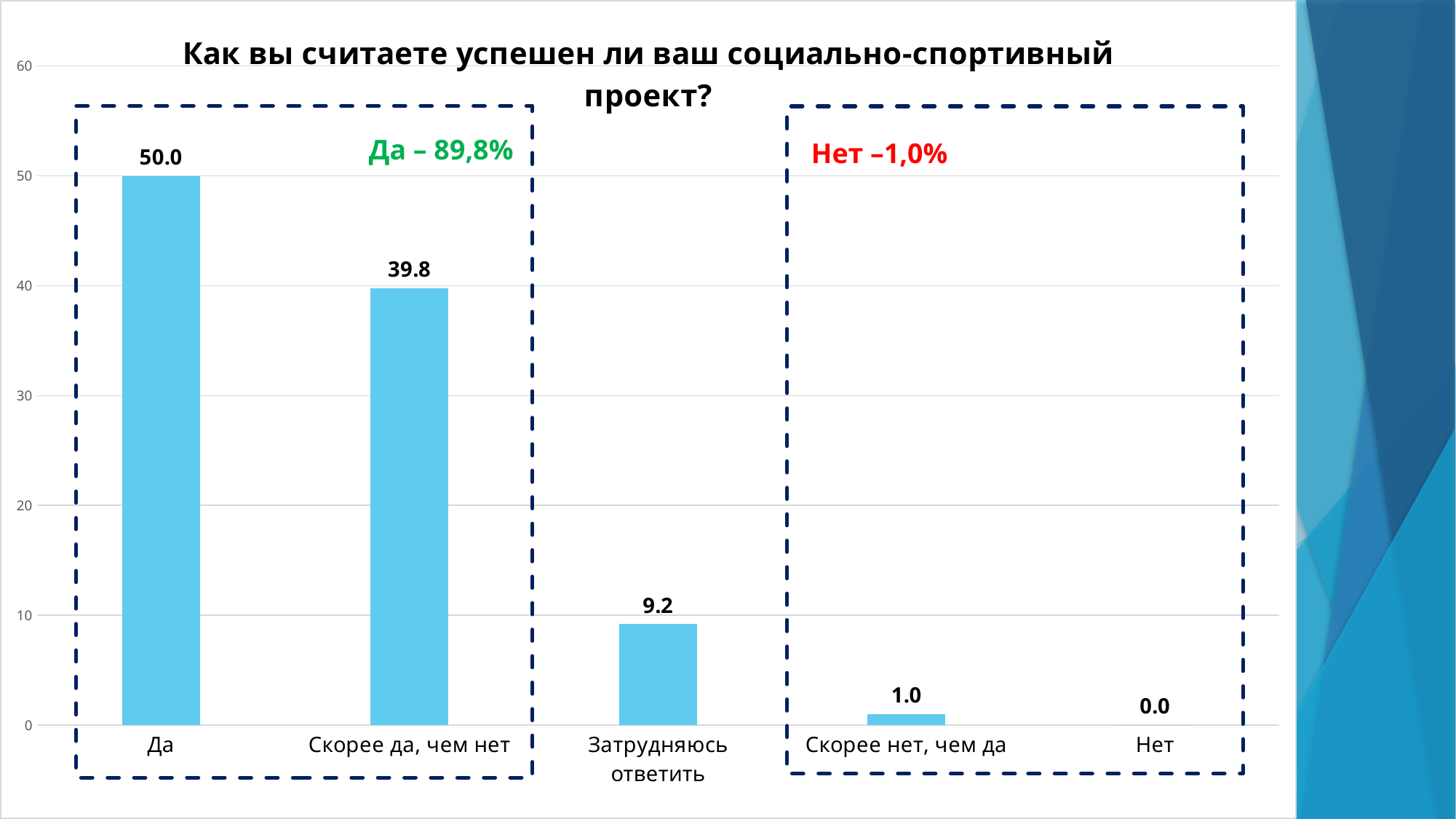
What is the difference between the values for "Да" and "Скорее да, чем нет"? 10.2 What is the value for "Да"? 50.0 Which is larger, the value for "Затрудняюсь ответить" or the value for "Скорее нет, чем да"? Затрудняюсь ответить Which category has the lowest value? Нет What is the title of the chart? Как вы считаете успешен ли ваш социально-спортивный проект? How many categories are shown on the x axis? 5 What is the value for "Нет"? 0.0 What kind of chart is shown on the slide? Bar chart What is the value for "Скорее да, чем нет"? 39.8 What is the value for "Затрудняюсь ответить"? 9.2 What is the value for "Скорее нет, чем да"? 1.0 Which category has the highest value? Да